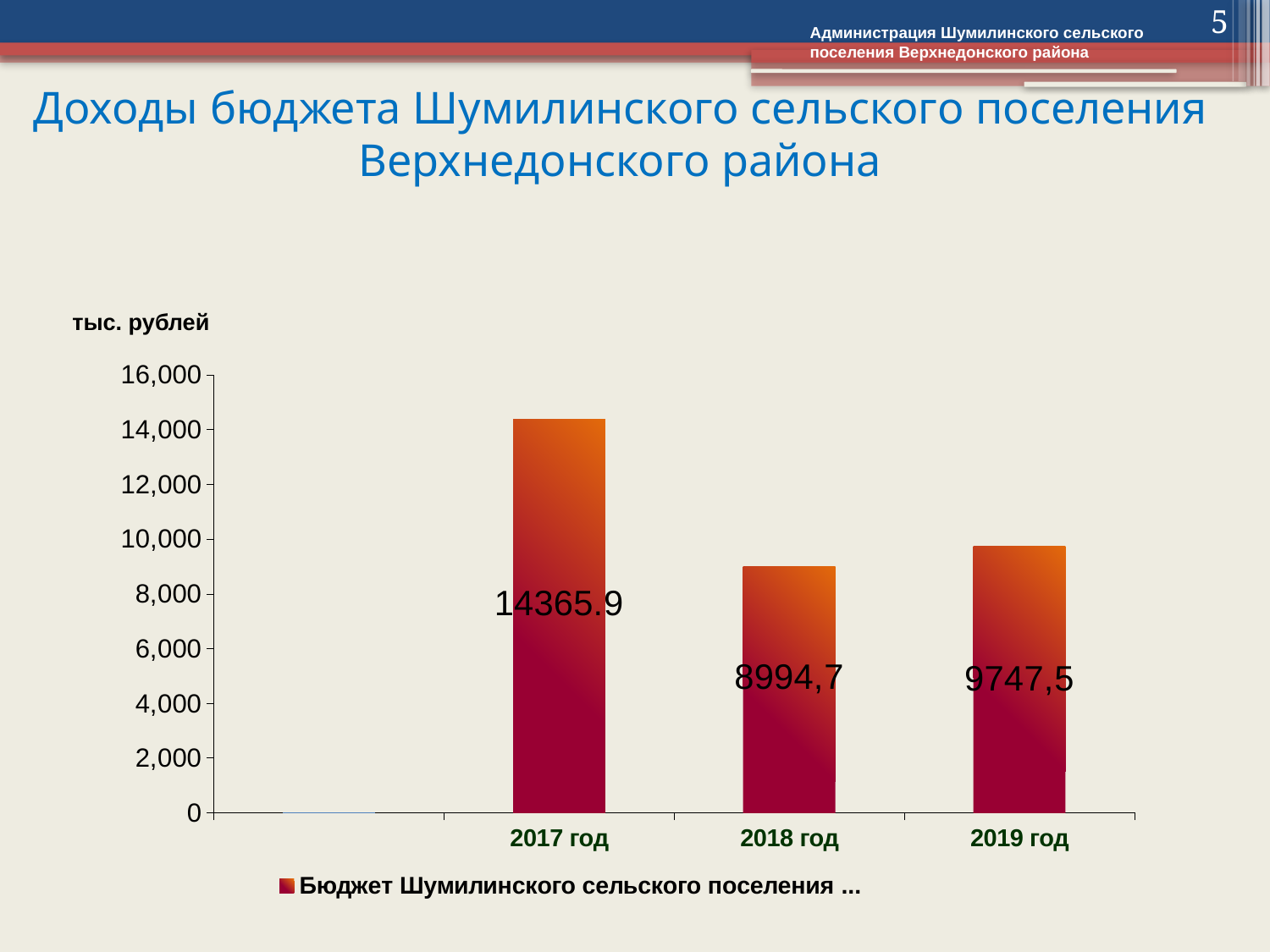
What is the value for 2018 год? 8994,7 What kind of chart is shown on the slide? bar chart What is the value for 2019 год? 9747,5 What is the difference between the values for 2019 год and 2018 год? 752,8 Which is larger, the value for 2019 год or the value for 2018 год? 2019 год What unit is given for the vertical axis? тыс. рублей What is the value for 2017 год? 14365.9 Which year has the highest value? 2017 год Is the value for 2017 год greater or less than 14,000? greater What is the difference between the values for 2017 год and 2018 год? 5371,2 How many years are labeled on the x axis? 3 Which year has the lowest value? 2018 год